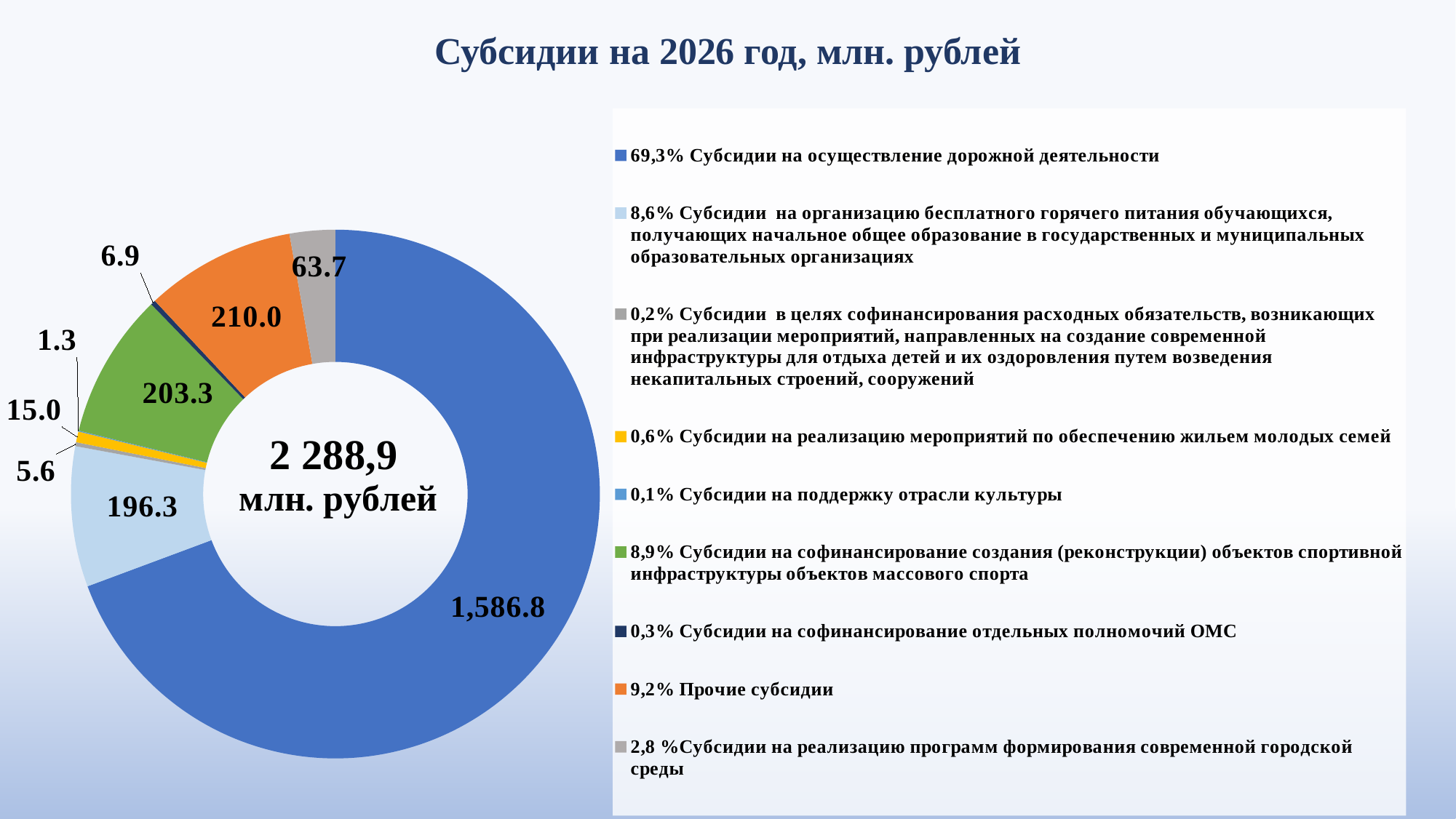
What is the value for 'Субсидии на софинансирование создания (реконструкции) объектов спортивной инфраструктуры объектов массового спорта'? 203.3 What is the value for 'Субсидии на осуществление дорожной деятельности'? 1,586.8 Which category has the smallest slice? Субсидии на поддержку отрасли культуры What is the difference between 'Прочие субсидии' and the sports infrastructure subsidies? 6.7 Which category has the largest slice? Субсидии на осуществление дорожной деятельности How many slices does the chart have? 9 What is the value for 'Прочие субсидии'? 210.0 What kind of chart is shown on the slide? doughnut (pie) chart What total is shown in the centre of the chart? 2 288,9 млн. рублей What is the value for 'Субсидии на реализацию программ формирования современной городской среды'? 63.7 What share of the total do the subsidies for road activity ('Субсидии на осуществление дорожной деятельности') represent? 69,3% Which is larger: the subsidies for free hot meals for students (196.3) or the subsidies for sports infrastructure (203.3)? Subsidies for sports infrastructure (203.3)